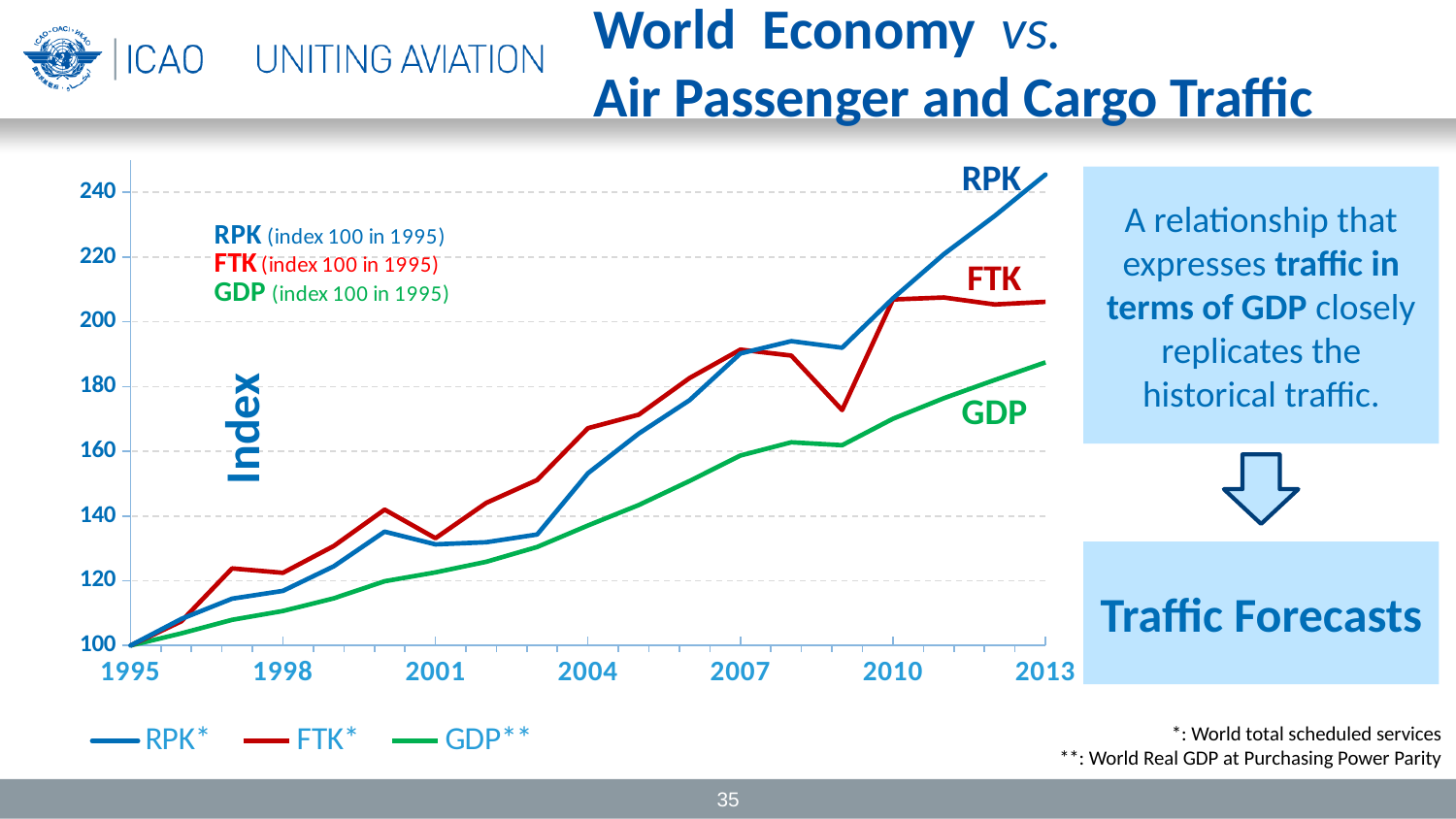
Does the GDP index rise or fall from 1995 to 2013? rise Is the value for GDP in 2013 greater or less than 200? less Which series has the lowest index value in 2013? GDP What is the index value of RPK in 1995? 100 Is the value for FTK in 2013 greater or less than 200? greater Is the value for RPK in 2013 greater or less than 240? greater What kind of chart is shown on the slide? line chart Which is larger in 2000, the FTK index or the GDP index? FTK How many series does the legend of the chart list? 3 What is the index value of GDP in 1995? 100 Which series has the highest index value in 2013? RPK